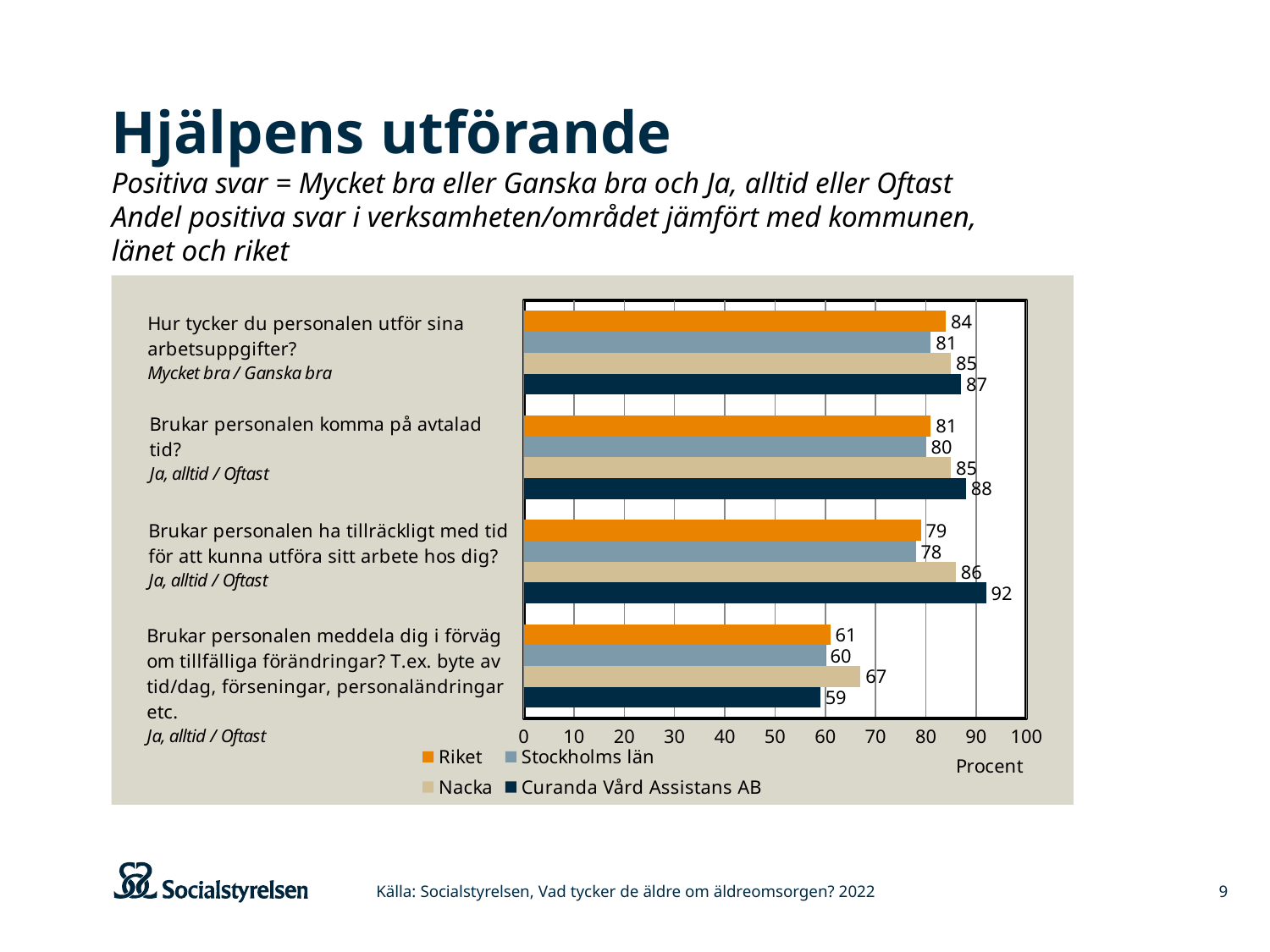
How many series does the legend list? 4 What is the value for Stockholms län on the question "Brukar personalen komma på avtalad tid?"? 80 On the question "Brukar personalen komma på avtalad tid?", which is larger: Nacka or Riket? Nacka What kind of chart is shown on the slide? Bar chart What is the value for Nacka on the question "Brukar personalen meddela dig i förväg om tillfälliga förändringar?"? 67 What is the difference between Curanda Vård Assistans AB and Riket on the question "Brukar personalen ha tillräckligt med tid för att kunna utföra sitt arbete hos dig?"? 13 What is the value for Curanda Vård Assistans AB on the question "Brukar personalen ha tillräckligt med tid för att kunna utföra sitt arbete hos dig?"? 92 Is the value for Curanda Vård Assistans AB on the question "Brukar personalen meddela dig i förväg om tillfälliga förändringar?" greater or less than 60? less How many questions (categories) are shown in the chart? 4 Which series has the lowest value on the question "Brukar personalen ha tillräckligt med tid för att kunna utföra sitt arbete hos dig?"? Stockholms län What is the value for Riket on the question "Hur tycker du personalen utför sina arbetsuppgifter?"? 84 Which series has the highest value on the question "Brukar personalen meddela dig i förväg om tillfälliga förändringar?"? Nacka